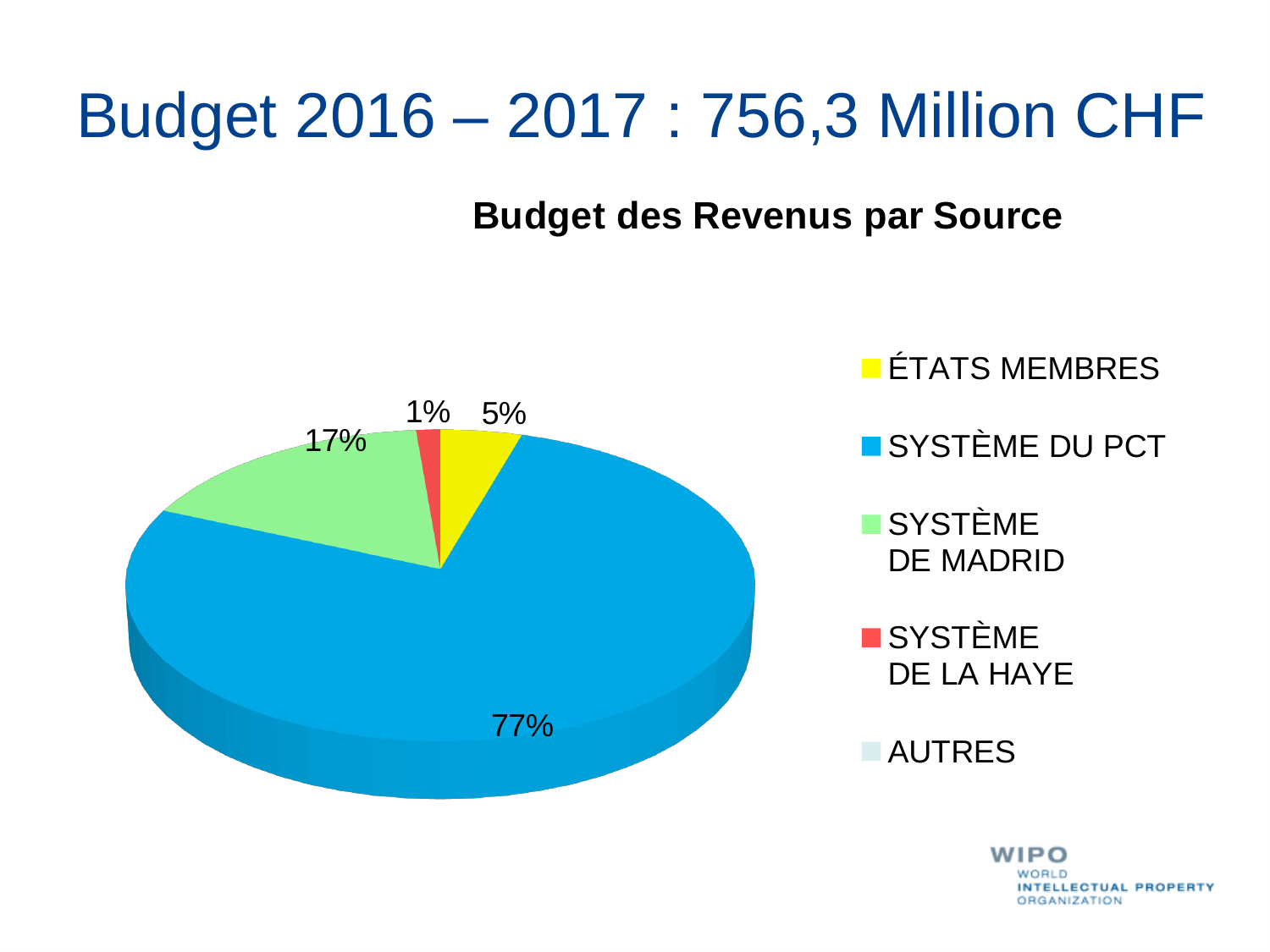
What percentage of the budget revenue comes from SYSTÈME DU PCT? 77% What percentage of the budget revenue comes from SYSTÈME DE LA HAYE? 1% Which colour represents SYSTÈME DE MADRID in the chart? Green What type of chart is shown on the slide? Pie chart What is the difference in percentage points between the SYSTÈME DU PCT share and the SYSTÈME DE MADRID share? 60 percentage points Which is larger, the share for ÉTATS MEMBRES or the share for SYSTÈME DE LA HAYE? ÉTATS MEMBRES How many entries does the legend list? 5 Is the share for SYSTÈME DU PCT greater or less than 50%? greater Which source accounts for the largest share of the budget revenue? SYSTÈME DU PCT What is the title of the chart? Budget des Revenus par Source What percentage of the budget revenue comes from ÉTATS MEMBRES? 5% What percentage of the budget revenue comes from SYSTÈME DE MADRID? 17%